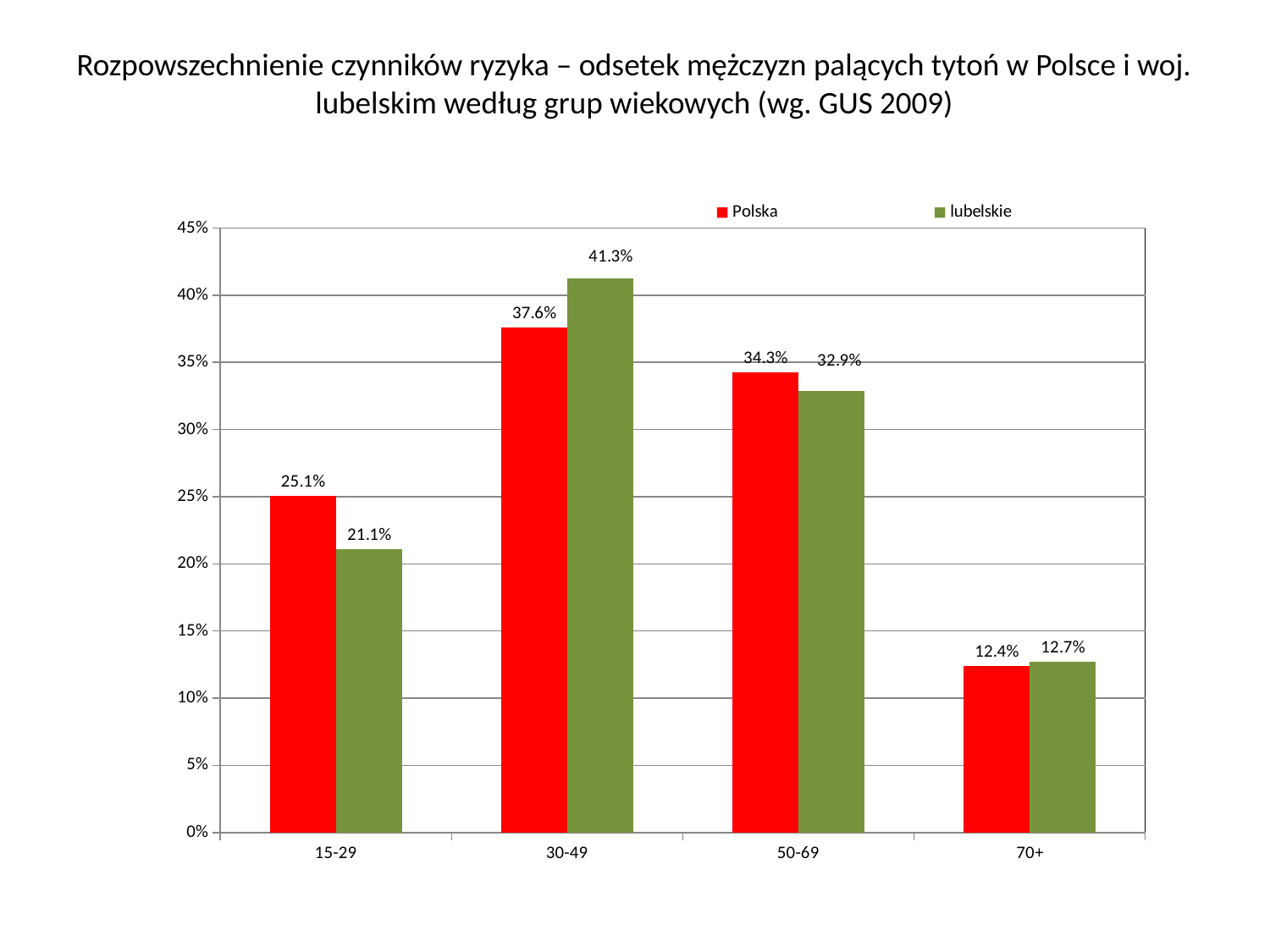
What is the value for lubelskie in the 15-29 age group? 21.1% Is the value for Polska in the 15-29 age group greater or less than 20%? greater What kind of chart is shown on the slide? bar chart Which age group has the highest value for lubelskie? 30-49 How many age groups are shown on the x axis? 4 What is the value for lubelskie in the 70+ age group? 12.7% What is the value for Polska in the 30-49 age group? 37.6% How many series does the legend list? 2 What is the difference between the lubelskie and Polska values in the 30-49 age group? 3.7% Which colour represents the Polska series? red Which is larger in the 50-69 age group, Polska or lubelskie? Polska Which age group has the lowest value for Polska? 70+